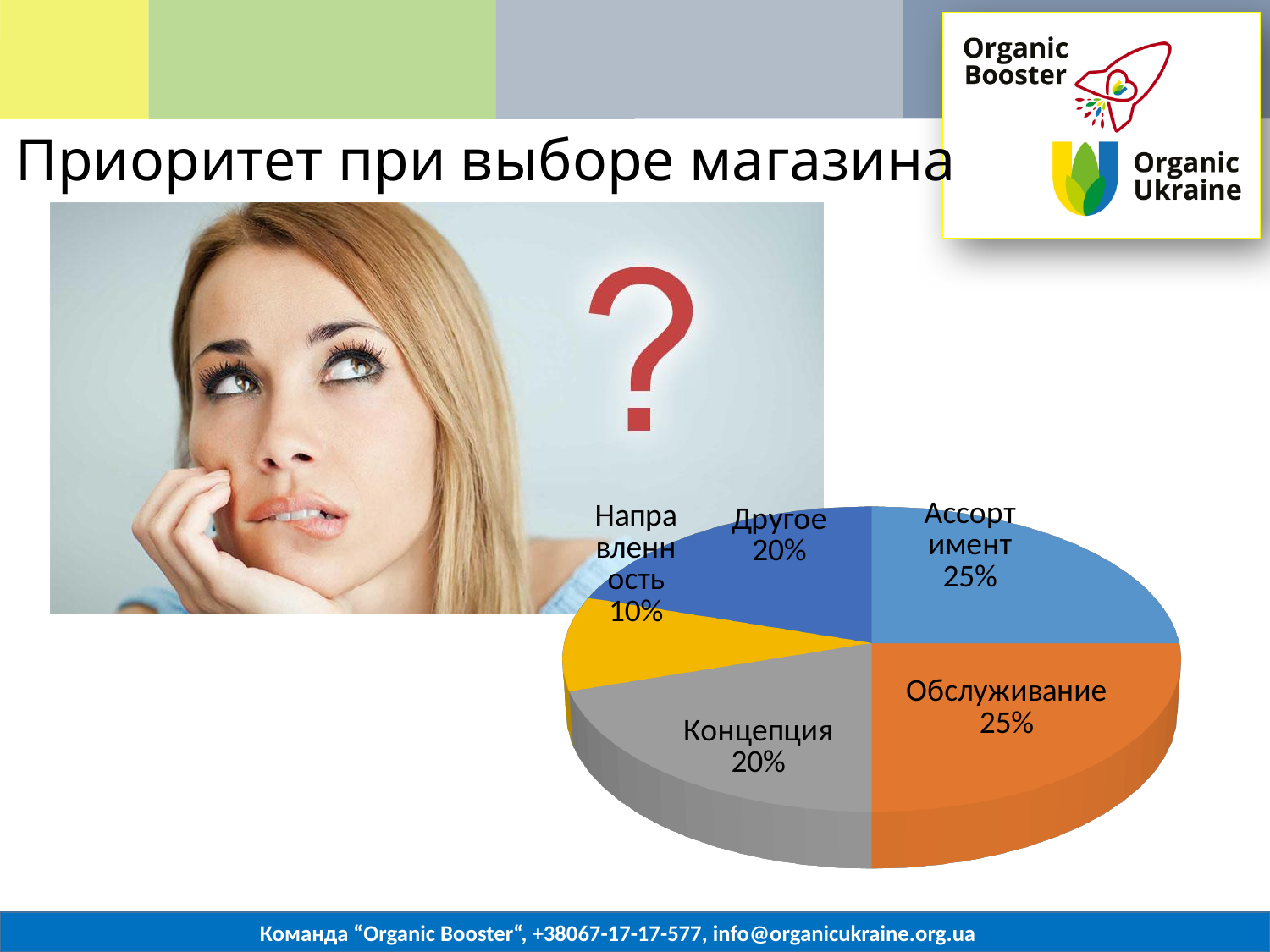
Which category has the smallest slice of the pie? Направленность What is the title of the slide containing the pie chart? Приоритет при выборе магазина Which is larger, the slice for Концепция or the slice for Направленность? Концепция What share of the pie does Обслуживание have? 25% What share of the pie does Концепция have? 20% What kind of chart is shown on the slide? pie chart What share of the pie does Другое have? 20% How many slices does the pie chart have? 5 What share of the pie does Ассортимент have? 25% What is the difference in percentage points between Ассортимент and Направленность? 15 What is the difference in percentage points between Обслуживание and Другое? 5 What share of the pie does Направленность have? 10%